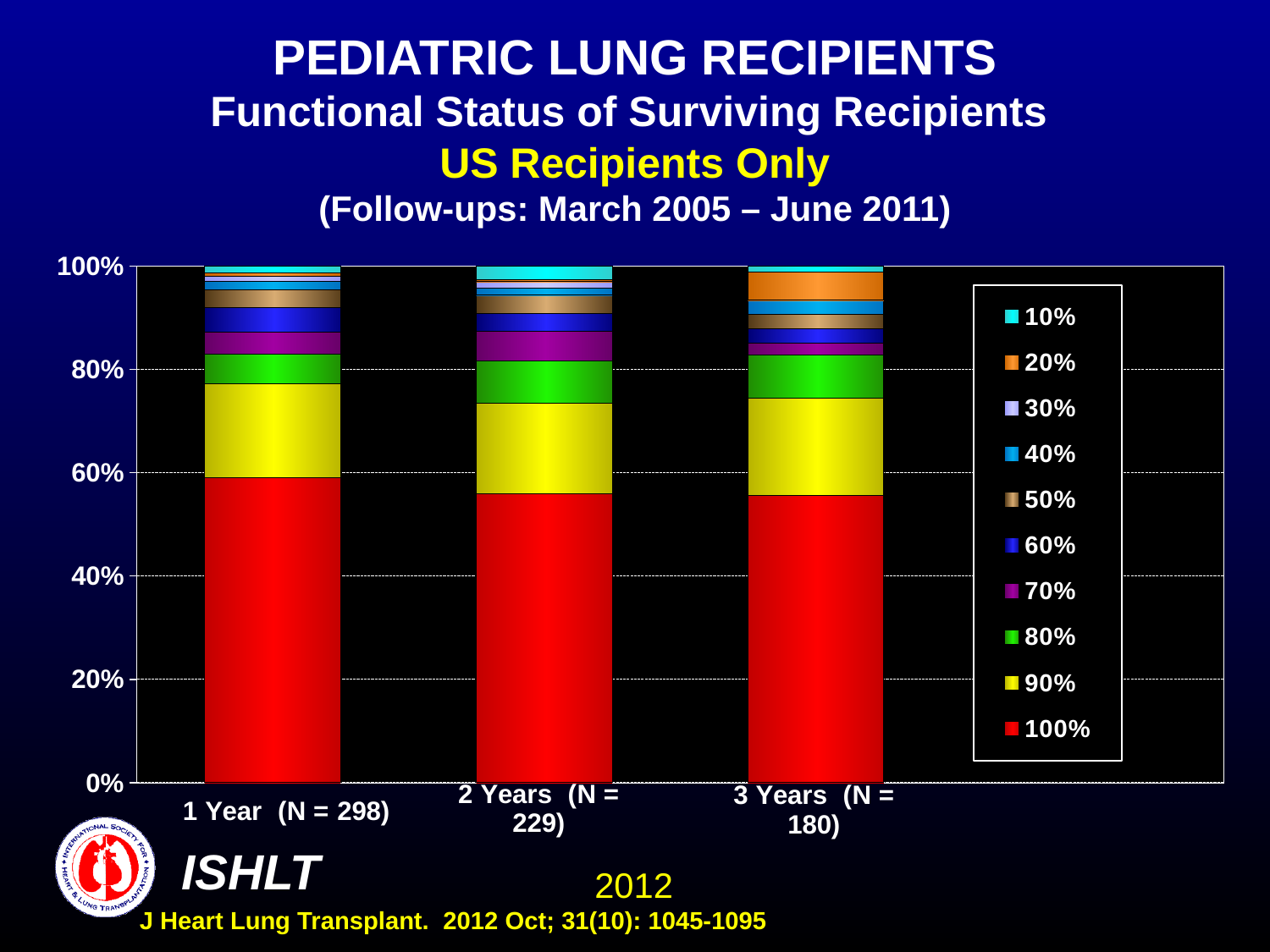
What is the N for the 1 Year category? 298 What kind of chart is shown on the slide? stacked bar chart What is the N for the 3 Years category? 180 What is the total height of the stacked bar for 1 Year? 100% How many series does the legend list? 10 Which series is shown in red in the legend? 100% Which bar has the larger 100% functional status segment, 1 Year or 3 Years? 1 Year What is the N for the 2 Years category? 229 What follow-up period is stated in the chart title? March 2005 – June 2011 Is the share of the 100% functional status series in the 3 Years bar greater or less than 40%? greater Is the share of the 100% functional status series in the 2 Years bar greater or less than 60%? less How many categories (follow-up time points) are shown on the x axis? 3